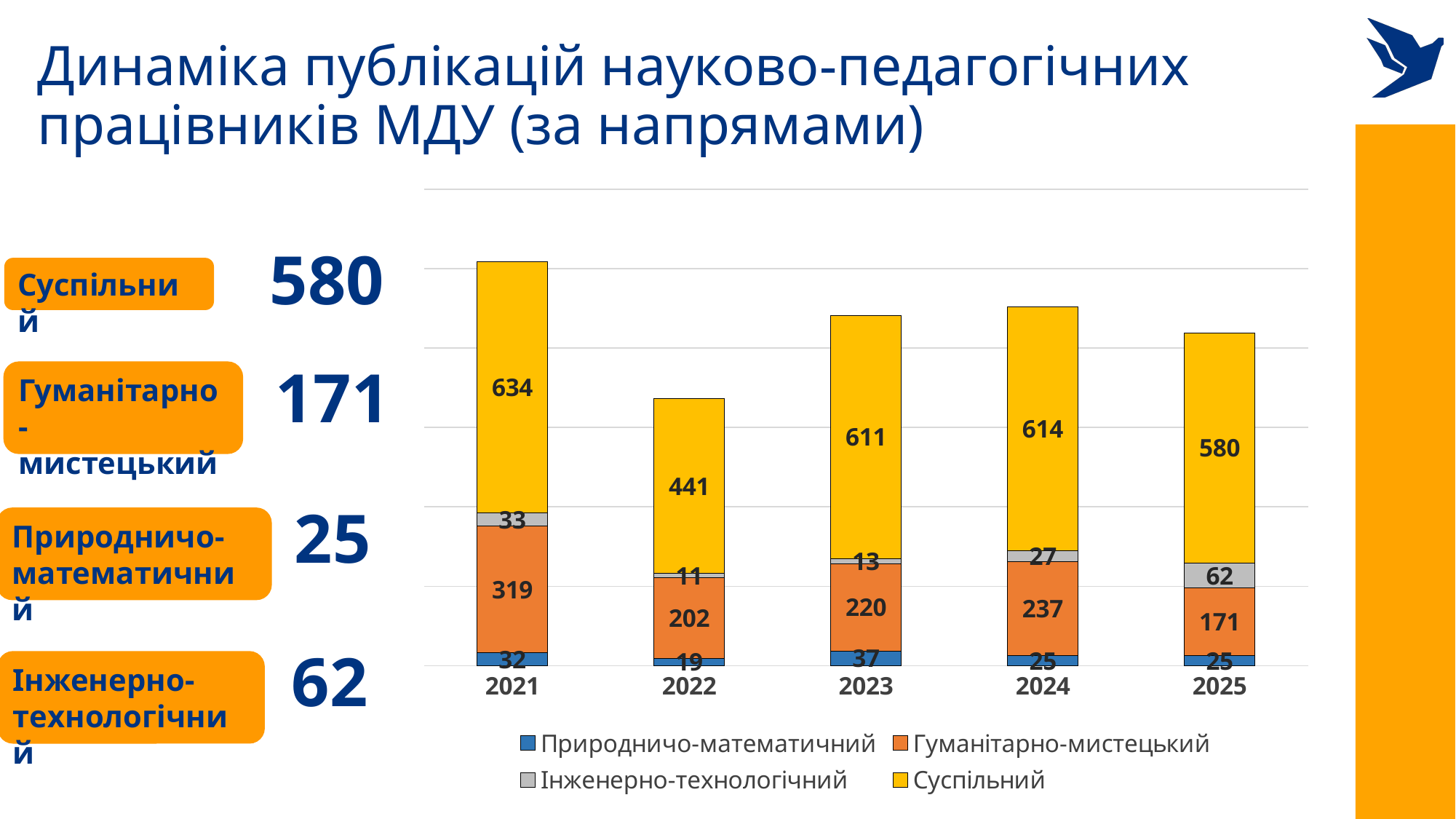
What kind of chart is shown on the slide? stacked bar chart How many series does the legend list? 4 In which year is the Суспільний value lowest? 2022 What is the total of the stacked bar for 2022? 673 What is the value for Гуманітарно-мистецький in 2024? 237 How many years are shown on the x axis? 5 What is the difference between the Суспільний values in 2024 and 2025? 34 What is the value for Природничо-математичний in 2023? 37 In which year is the Гуманітарно-мистецький value highest? 2021 What is the value for Суспільний in 2021? 634 Which is larger: the Інженерно-технологічний value in 2021 or in 2025? 2025 What is the value for Інженерно-технологічний in 2025? 62